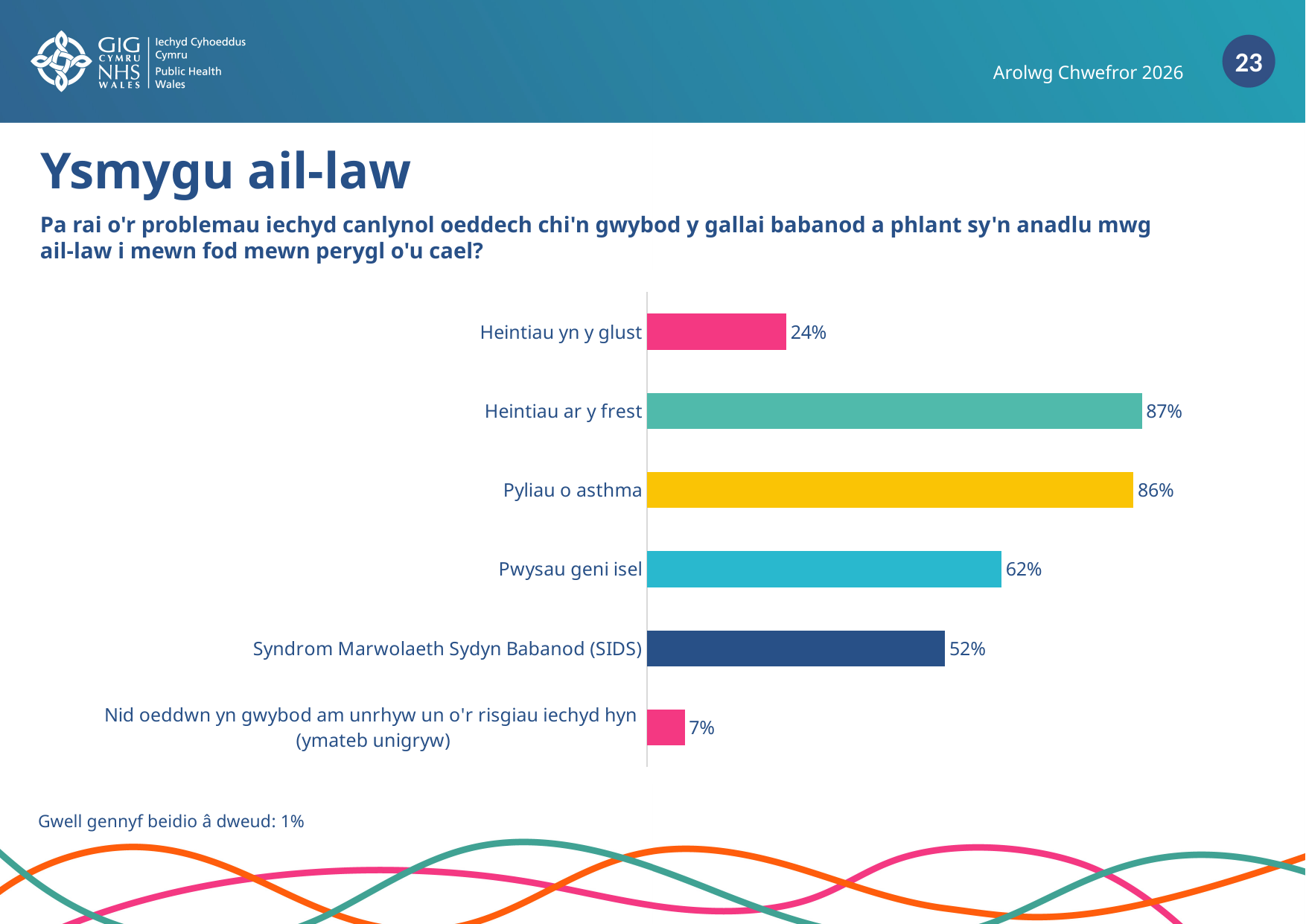
What is the difference between the values for 'Heintiau ar y frest' and 'Pyliau o asthma'? 1% Which category has the highest value in the chart? Heintiau ar y frest What is the difference between the values for 'Pyliau o asthma' and 'Pwysau geni isel'? 24% How many categories are plotted in the chart? 6 What percentage is shown for 'Syndrom Marwolaeth Sydyn Babanod (SIDS)'? 52% What is the value shown for 'Pwysau geni isel'? 62% What kind of chart is shown on the slide? Bar chart Which is larger: the value for 'Heintiau yn y glust' or the value for 'Syndrom Marwolaeth Sydyn Babanod (SIDS)'? Syndrom Marwolaeth Sydyn Babanod (SIDS) What percentage is given for 'Gwell gennyf beidio â dweud' below the chart? 1% What percentage of respondents knew about 'Heintiau ar y frest' (chest infections)? 87% What is the value for 'Heintiau yn y glust'? 24% Which category has the lowest value in the chart? Nid oeddwn yn gwybod am unrhyw un o'r risgiau iechyd hyn (ymateb unigryw)